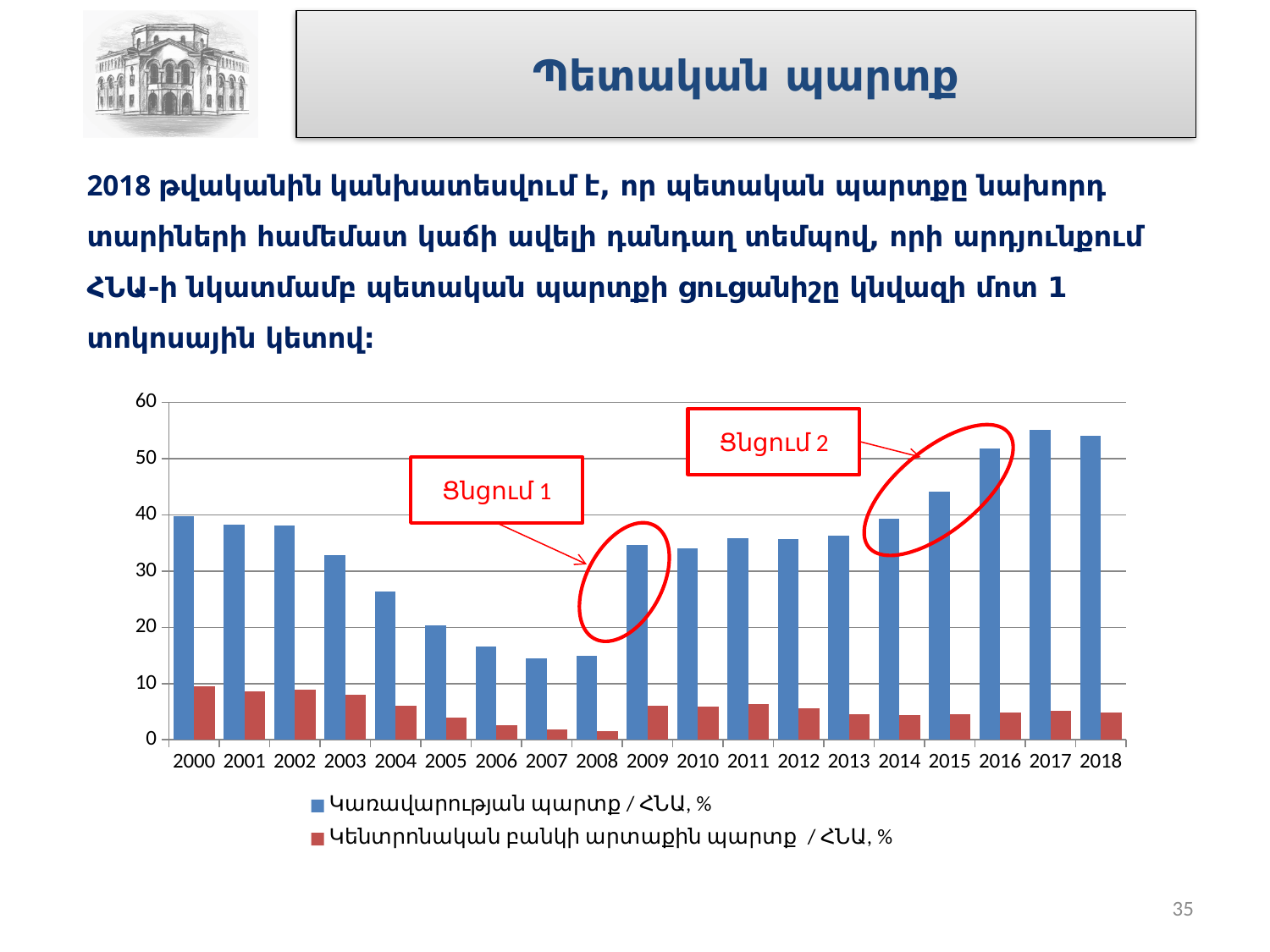
What colour are the bars for the Կառավարության պարտք / ՀՆԱ, % series? blue Is the value for Կառավարության պարտք / ՀՆԱ, % in 2017 greater or less than 50? greater What kind of chart is shown on the slide? bar chart Which is larger, the Կենտրոնական բանկի արտաքին պարտք / ՀՆԱ, % value for 2002 or for 2008? 2002 Which is larger, the Կառավարության պարտք / ՀՆԱ, % value for 2000 or for 2005? 2000 Is the value for Կենտրոնական բանկի արտաքին պարտք / ՀՆԱ, % in 2008 greater or less than 10? less Is the value for Կառավարության պարտք / ՀՆԱ, % in 2007 greater or less than 20? less Does the Կառավարության պարտք / ՀՆԱ, % series rise or fall from 2000 to 2007? fall Does the Կառավարության պարտք / ՀՆԱ, % series rise or fall from 2013 to 2017? rise How many series does the chart legend list? 2 How many years are shown on the x axis of the chart? 19